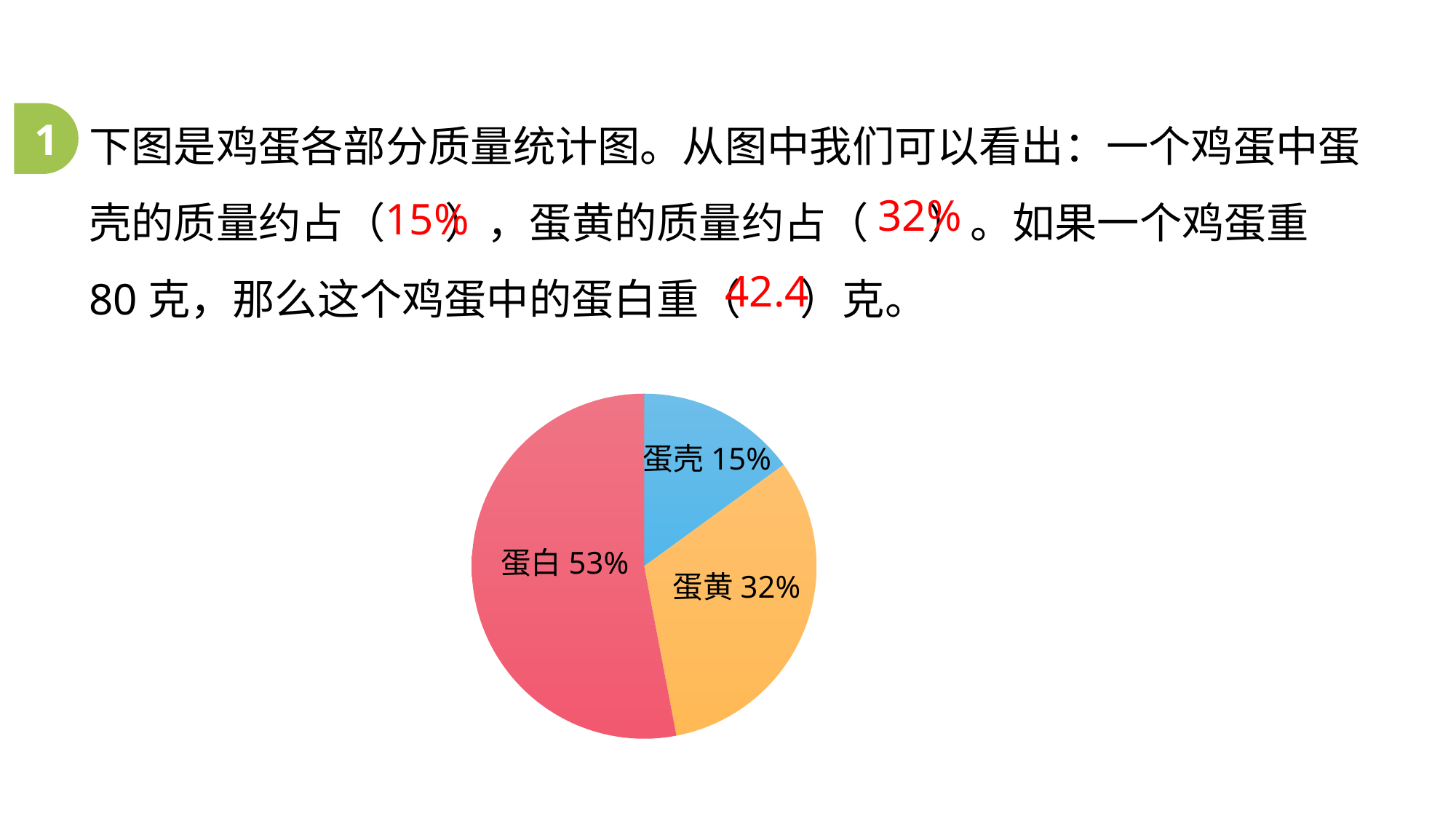
What is the difference in percentage points between 蛋黄 and 蛋壳? 17% What share of the pie does 蛋白 (egg white) take? 53% What share of the pie does 蛋壳 (egg shell) take? 15% What kind of chart is shown on the slide? pie chart What is the difference in percentage points between 蛋白 and 蛋黄? 21% Which part of the egg has the smallest slice in the pie chart? 蛋壳 Which part of the egg has the largest slice in the pie chart? 蛋白 How many slices does the pie chart have? 3 What colour is the 蛋白 slice in the pie chart? red What colour is the 蛋壳 slice in the pie chart? blue Which slice is larger, 蛋黄 or 蛋壳? 蛋黄 What share of the pie does 蛋黄 (egg yolk) take? 32%